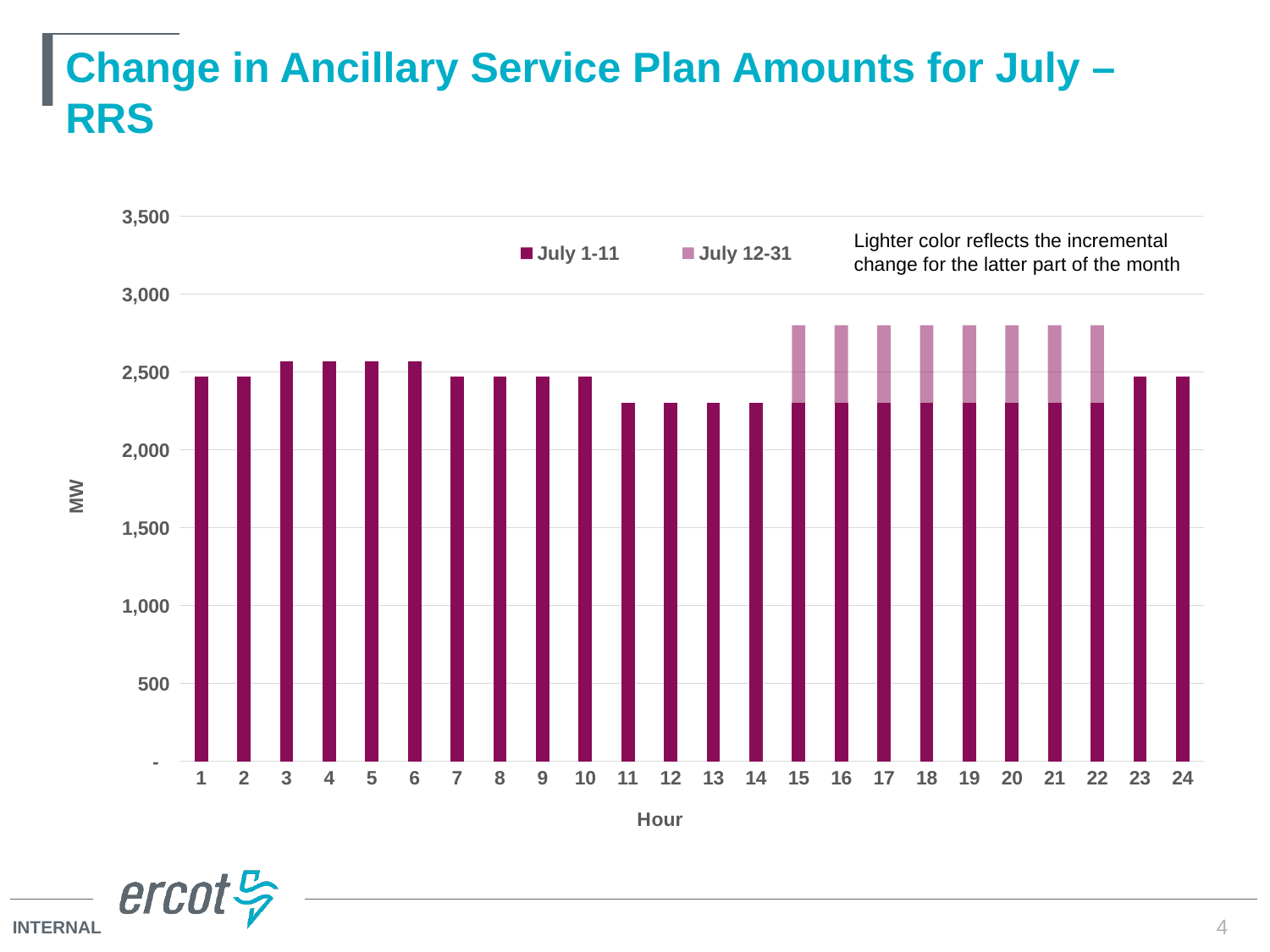
What kind of chart is shown on the slide? Stacked bar chart Which hours have a July 12-31 (lighter) segment on top of the bar? Hours 15 through 22 Is the total stacked value for hour 18 greater or less than 3,000? less Is the July 1-11 value for hour 11 greater or less than 2,500? less Is the total stacked value for hour 15 greater or less than 2,500? greater Which hours have the lowest total bars? Hours 11 through 14 How many series does the legend list? 2 Which is larger, the July 1-11 value for hour 6 or for hour 12? Hour 6 What are the two series named in the legend? July 1-11 and July 12-31 How many hours are plotted along the x axis? 24 What is the label on the y axis? MW